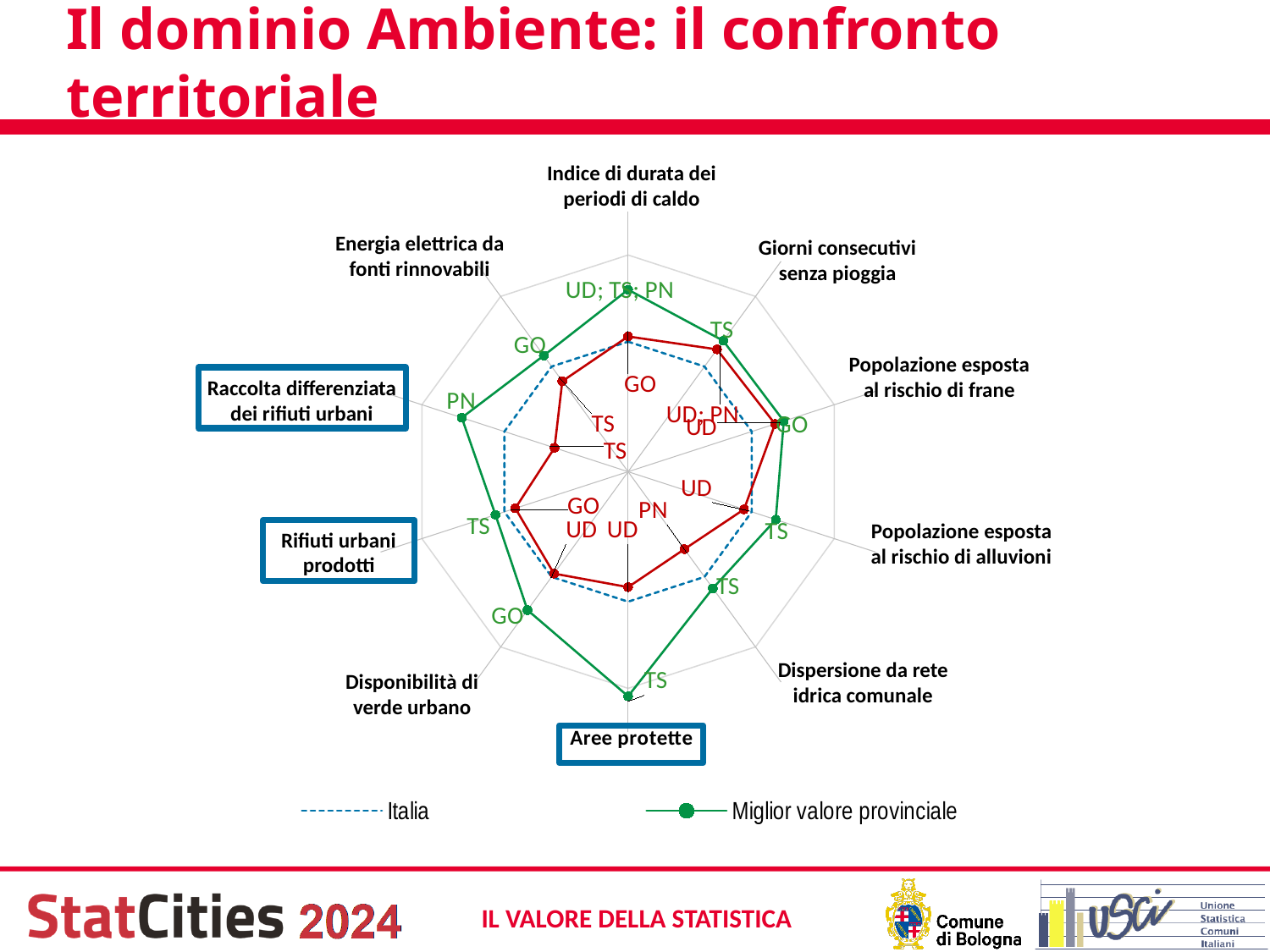
What kind of chart is shown on the slide? Radar chart Which province is labelled as the best provincial value for Aree protette? TS Which province is labelled as the best provincial value for Dispersione da rete idrica comunale? TS How many indicator axes does the radar chart have? 10 Which province is labelled as the best provincial value for Disponibilità di verde urbano? GO How many series does the legend list? 2 Which province is labelled as the best provincial value for Energia elettrica da fonti rinnovabili? GO Which province is labelled as the best provincial value for Popolazione esposta al rischio di frane? GO What are the two series named in the legend? Italia; Miglior valore provinciale Which indicator is placed at the top of the radar chart? Indice di durata dei periodi di caldo Which provinces share the best provincial value for Indice di durata dei periodi di caldo? UD; TS; PN Which province is labelled as the best provincial value for Raccolta differenziata dei rifiuti urbani? PN